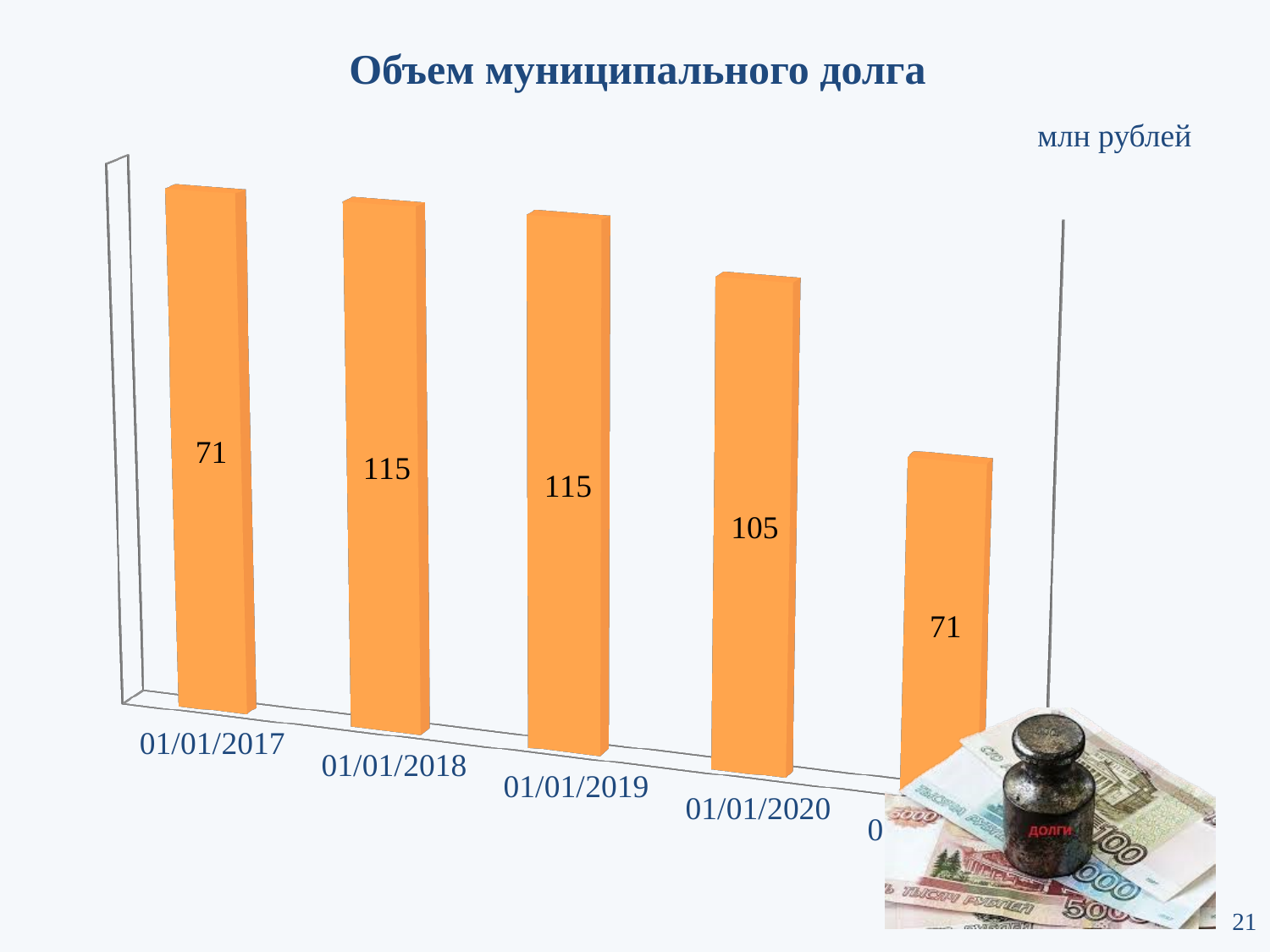
What kind of chart is shown on the slide? bar chart What is the title of the chart? Объем муниципального долга How many bars are shown in the chart? 5 What is the difference between the values for 01/01/2018 and 01/01/2020? 10 Which is larger, the value for 01/01/2018 or the value for 01/01/2020? 01/01/2018 In what units are the values of the chart given? млн рублей Which is larger, the value for 01/01/2019 or the value for 01/01/2020? 01/01/2019 What is the value for 01/01/2017? 71 What is the difference between the values for 01/01/2019 and 01/01/2020? 10 What is the value for 01/01/2018? 115 What is the value for 01/01/2020? 105 What is the value for 01/01/2019? 115